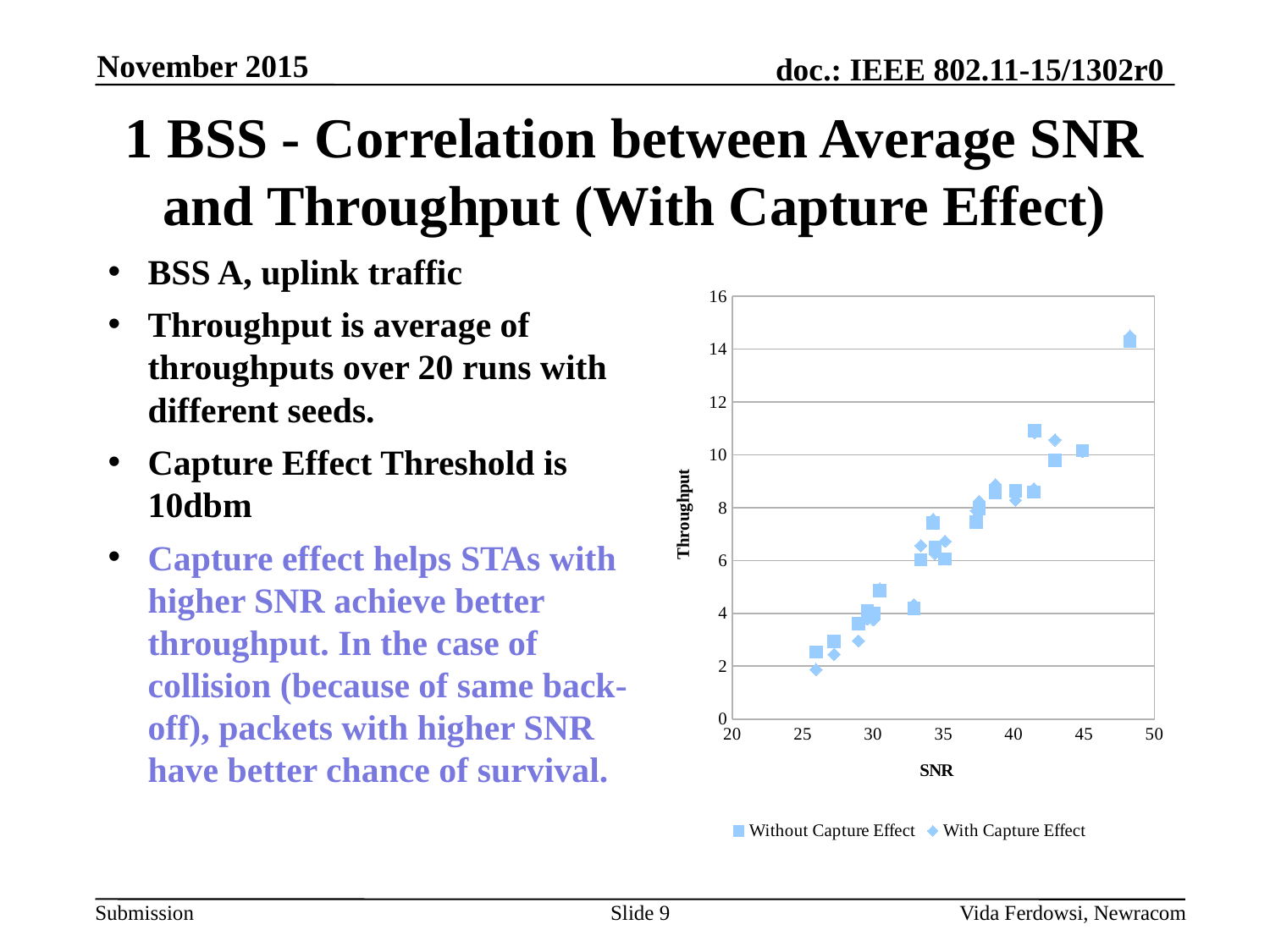
What kind of chart is shown on the slide? scatter chart Is the throughput of the point with the highest SNR greater or less than 12? greater For points with SNR below 30, is the throughput greater or less than 6? less What are the two series named in the chart legend? Without Capture Effect and With Capture Effect Is the throughput of the point with the lowest SNR greater or less than 4? less As SNR increases along the x axis, does throughput rise or fall? rise What are the titles of the x axis and y axis of the chart? SNR (x axis) and Throughput (y axis) How many series does the chart legend list? 2